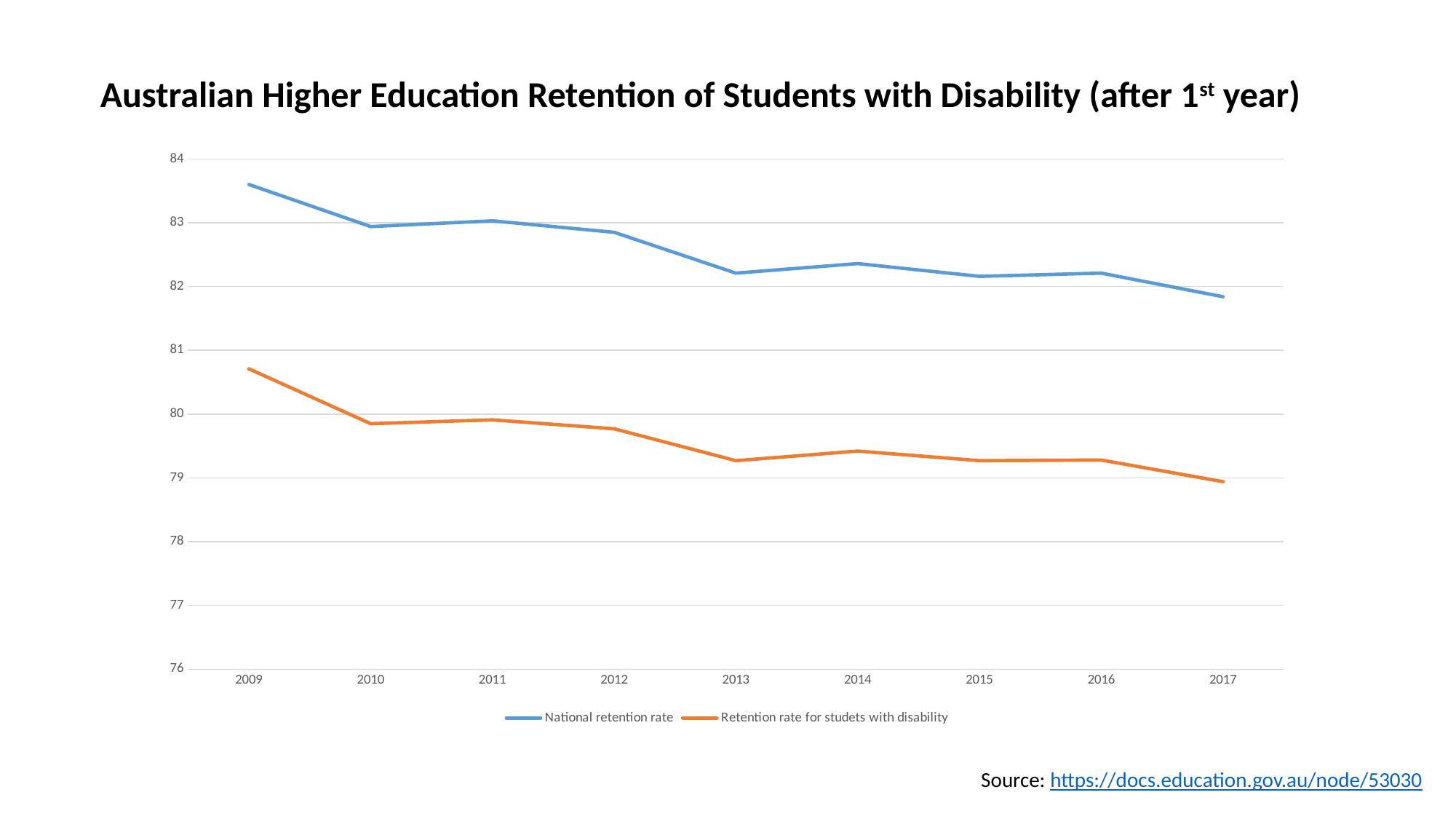
What kind of chart is shown on the slide? line chart How many series does the legend list? 2 Which series has the higher value in 2014, National retention rate or Retention rate for students with disability? National retention rate What is the title of the chart? Australian Higher Education Retention of Students with Disability (after 1st year) Does the National retention rate generally rise or fall from 2009 to 2017? fall Does the Retention rate for students with disability generally rise or fall from 2009 to 2017? fall In which year is the National retention rate highest? 2009 In which year is the Retention rate for students with disability lowest? 2017 Is the National retention rate in 2017 greater or less than 82? less How many years are plotted along the x axis? 9 Is the National retention rate in 2009 greater or less than 83? greater